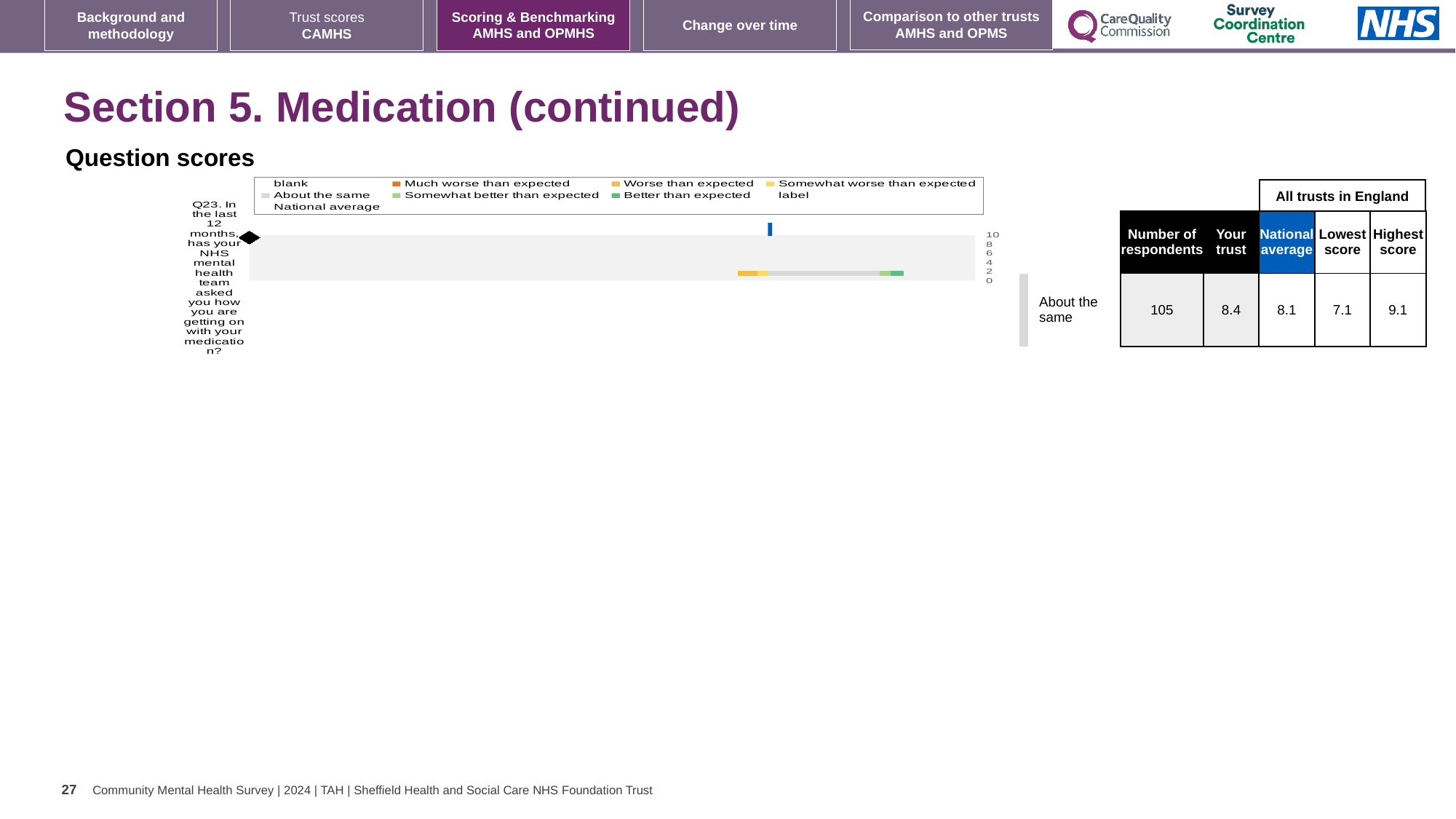
What is the highest value shown on the chart's axis? 10 According to the table beside the chart, how many respondents answered Q23? 105 What kind of chart is shown on the slide? bar chart How many questions (categories) are plotted in the chart? 1 According to the table beside the chart, what is the 'Your trust' score for Q23? 8.4 Which is larger for Q23: the 'Your trust' score or the national average? Your trust According to the table beside the chart, what is the highest score among all trusts in England for Q23? 9.1 According to the table beside the chart, what is the national average score for Q23? 8.1 According to the table beside the chart, what is the lowest score among all trusts in England for Q23? 7.1 What is the difference between the highest score and the lowest score for Q23 in the table beside the chart? 2.0 How many entries does the chart's legend list? 9 Which question number is plotted in the chart? Q23